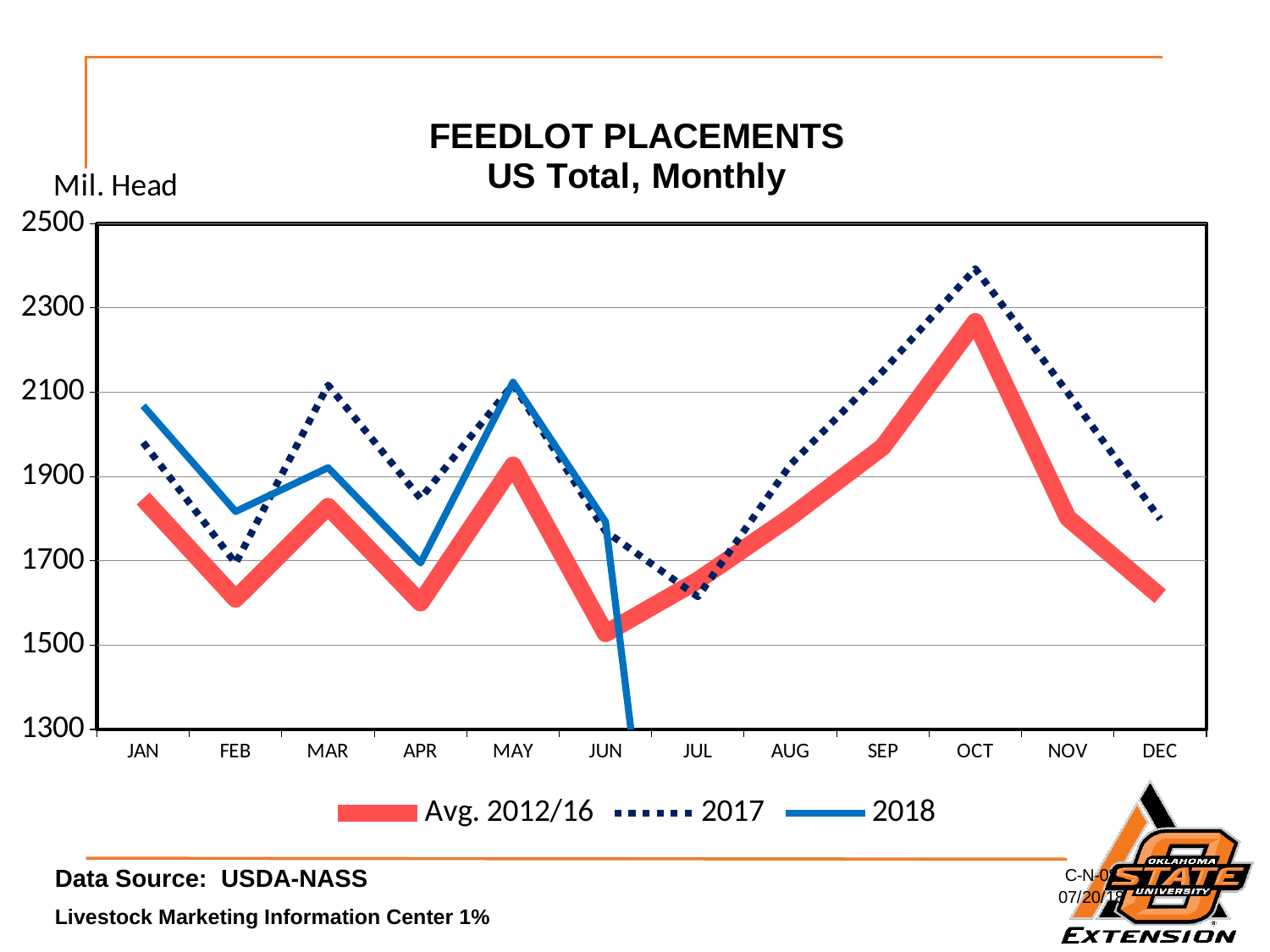
Is the 2018 value for JAN greater or less than 2100? less Does the Avg. 2012/16 series rise or fall from OCT to DEC? fall Is the 2017 value for OCT greater or less than 2300? greater In JAN, which series has the higher value, 2018 or Avg. 2012/16? 2018 What kind of chart is shown on the slide? line chart Is the Avg. 2012/16 value for FEB greater or less than 1700? less How many series does the legend list? 3 In which month is the Avg. 2012/16 series at its lowest? JUN In which month does the 2017 series reach its highest value? OCT In MAR, which series has the higher value, 2017 or 2018? 2017 How many months are shown along the x axis? 12 In which month does the Avg. 2012/16 series reach its highest value? OCT